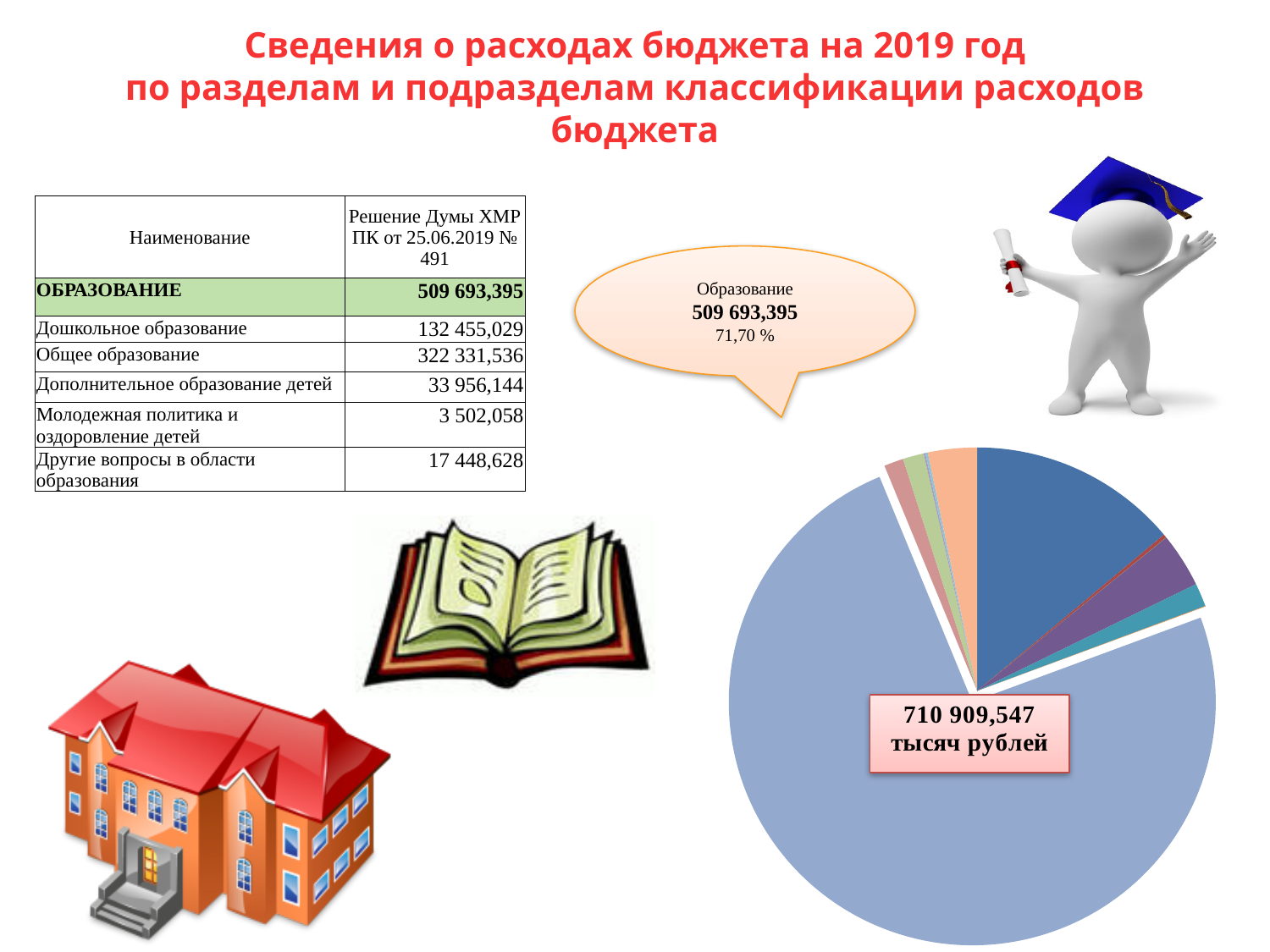
What kind of chart is shown on the slide? pie chart According to the callout on the pie chart, which category does the largest slice represent? Образование Does the pie chart have a legend listing its categories? No Is the share of the Образование slice greater or less than 50%? greater What total amount is printed in the box over the pie chart? 710 909,547 тысяч рублей What share of the pie does the Образование slice represent, according to the callout? 71,70 % What value is given for Образование in the callout on the pie chart? 509 693,395